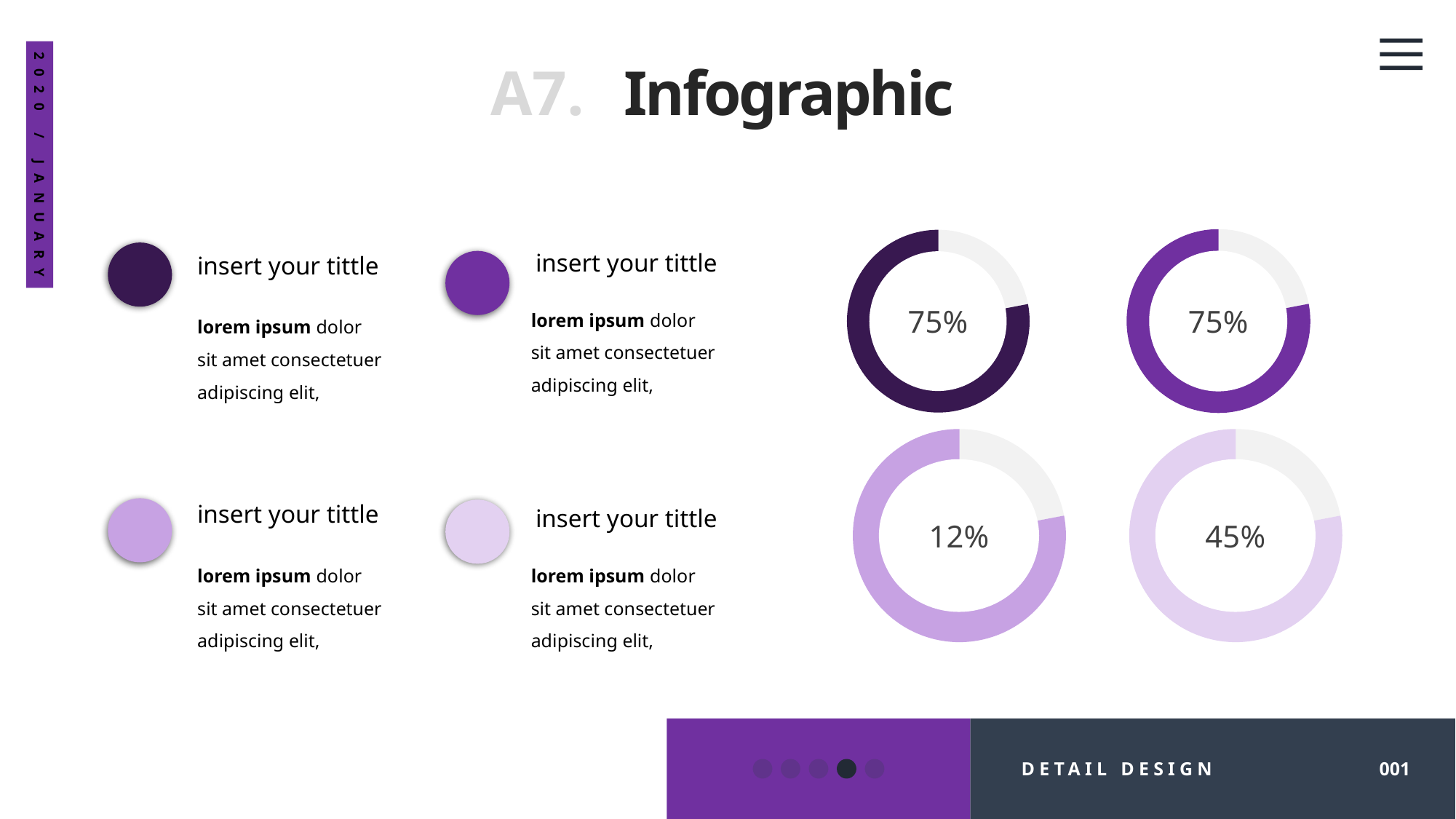
What value is shown in the centre of the bottom-right donut chart? 45% Which is larger, the percentage in the bottom-right donut chart or the percentage in the bottom-left donut chart? the bottom-right chart (45%) What is the difference between the percentage in the top-left donut chart and the percentage in the bottom-right donut chart? 30% What value is shown in the centre of the top-right donut chart? 75% What value is shown in the centre of the bottom-left donut chart? 12% What is the title of the slide containing the donut charts? A7. Infographic What is the difference between the percentage in the bottom-right donut chart and the percentage in the bottom-left donut chart? 33% What kind of chart is used to display the percentages on the right side of the slide? donut chart Which donut chart shows the lowest percentage? the bottom-left chart (12%) What value is shown in the centre of the top-left donut chart? 75% Do the top-left and top-right donut charts show the same percentage? Yes, both show 75% How many donut charts are on the slide? 4